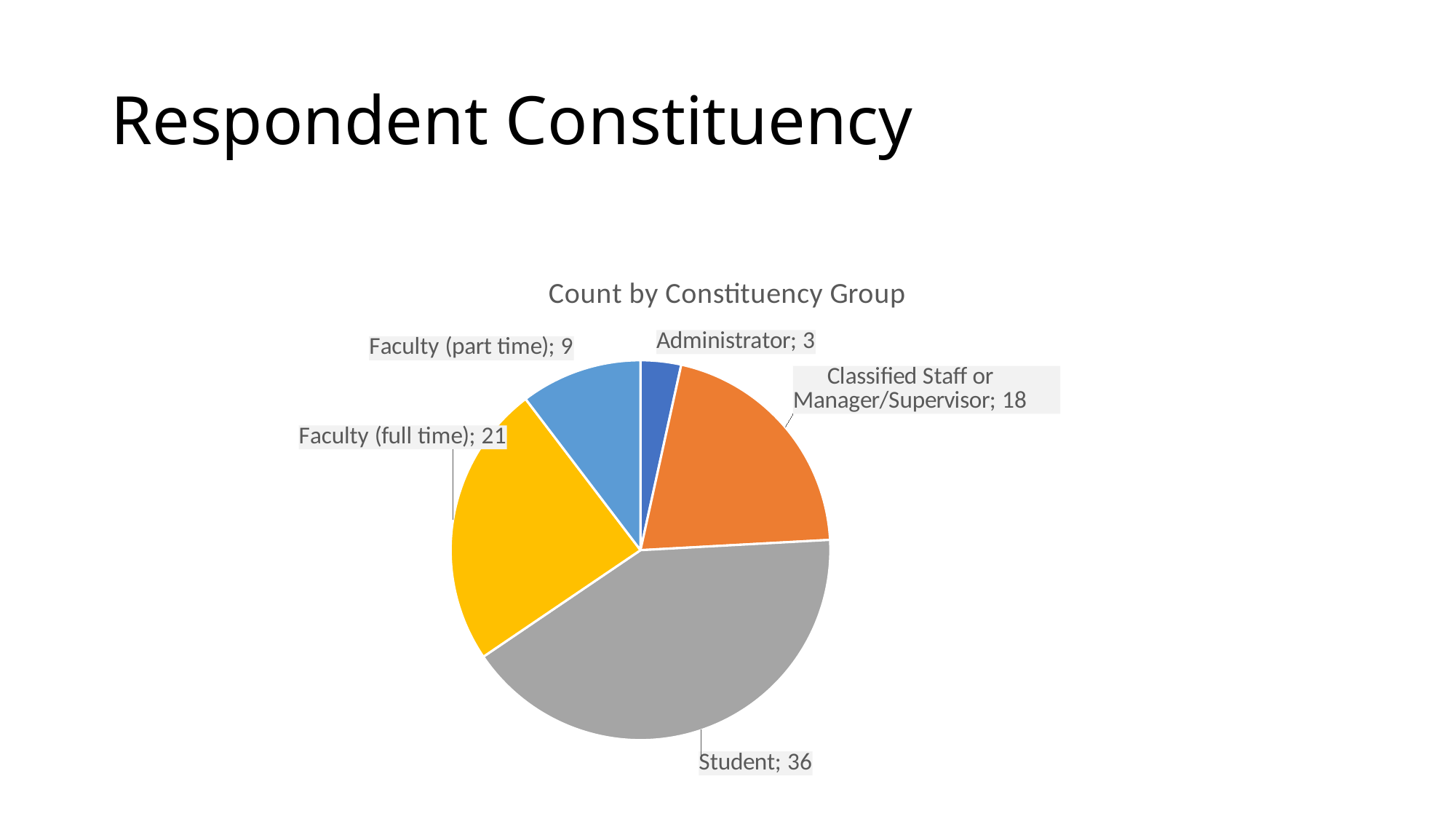
How many constituency groups are shown in the pie chart? 5 What is the difference between the Student count and the Faculty (full time) count? 15 Which constituency group has the smallest slice? Administrator What is the title of the chart? Count by Constituency Group Which is larger, Faculty (part time) or Classified Staff or Manager/Supervisor? Classified Staff or Manager/Supervisor How many respondents are Students? 36 What type of chart is shown on the slide? Pie chart What is the count for Classified Staff or Manager/Supervisor? 18 Which constituency group has the largest slice? Student What is the count for Administrator? 3 What is the count for Faculty (full time)? 21 What is the total count across all constituency groups? 87